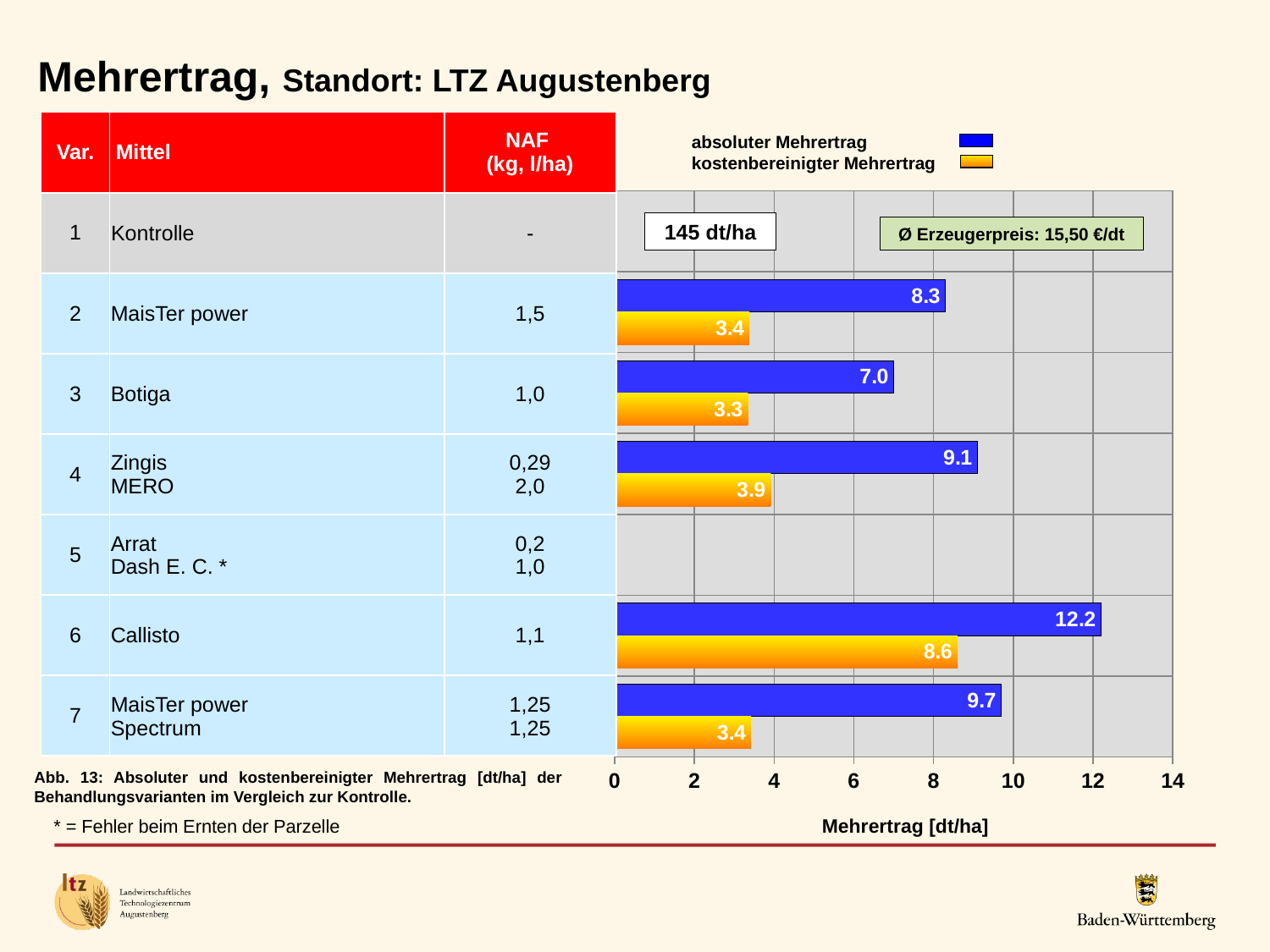
What is the absoluter Mehrertrag value for Callisto? 12.2 What is the absoluter Mehrertrag value for Zingis / MERO? 9.1 What is the difference between the absoluter and kostenbereinigter Mehrertrag for Callisto? 3.6 Which colour represents the kostenbereinigter Mehrertrag in the chart? yellow Which variant with plotted bars has the lowest absoluter Mehrertrag? Botiga What kind of chart is shown on the slide? bar chart What is the label of the x axis of the chart? Mehrertrag [dt/ha] What is the kostenbereinigter Mehrertrag value for Botiga? 3.3 Which variant has the highest absoluter Mehrertrag? Callisto Which is larger, the absoluter Mehrertrag for MaisTer power or for MaisTer power / Spectrum? MaisTer power / Spectrum How many series does the chart legend list? 2 Is the kostenbereinigter Mehrertrag for Callisto greater or less than 8? greater